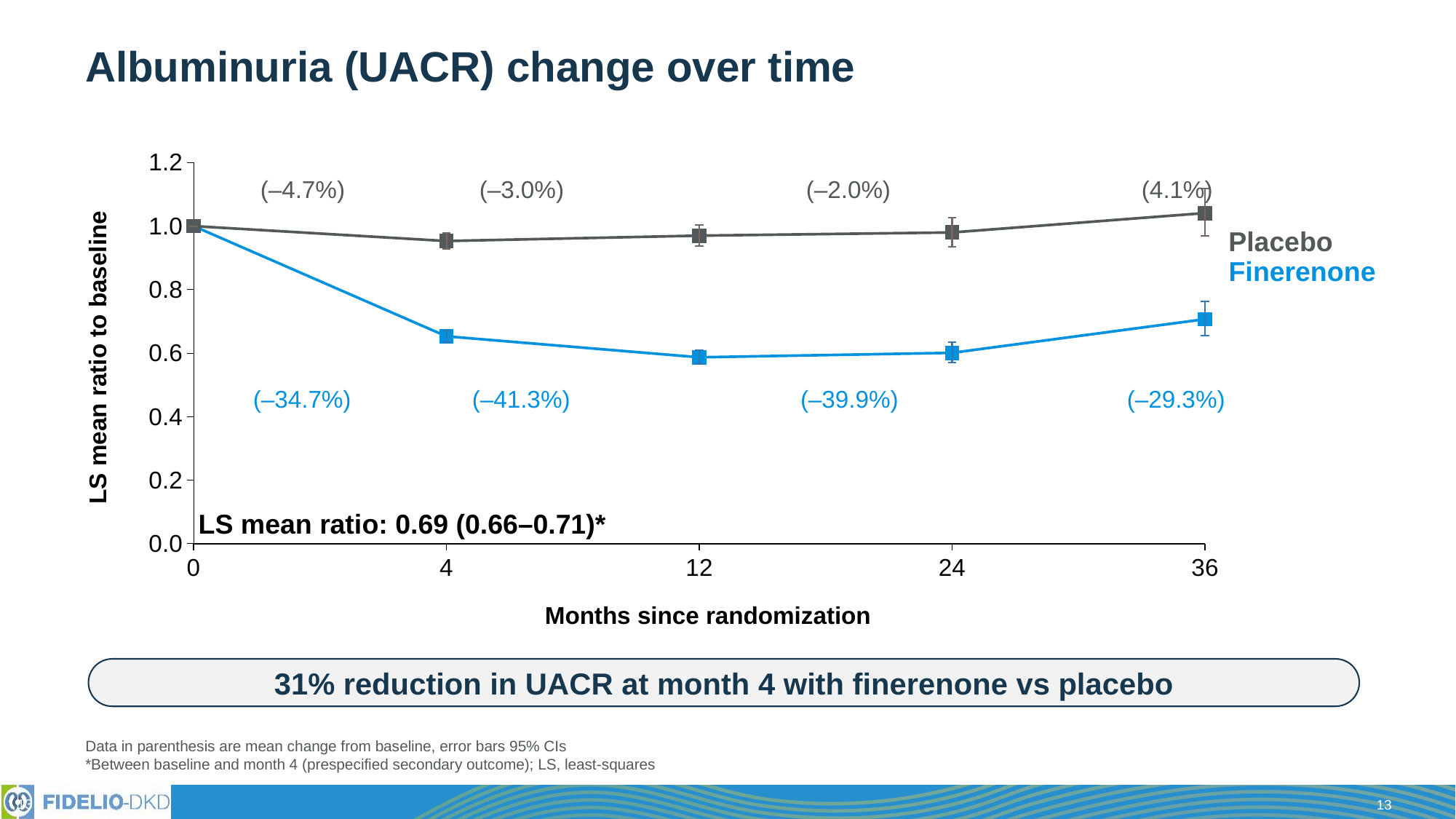
At which month is the finerenone mean change from baseline most negative? Month 12 What is the mean change from baseline for finerenone at month 12? –41.3% Does the finerenone line rise or fall between month 0 and month 12? Falls How many series are plotted in the chart? 2 What LS mean ratio is annotated on the chart? 0.69 (0.66–0.71) Is the LS mean ratio to baseline for finerenone at month 12 greater or less than 0.8? less What is the mean change from baseline for finerenone at month 4? –34.7% How many time points are plotted along the x axis? 5 What kind of chart is shown on the slide? Line chart At month 4, which series has the higher LS mean ratio to baseline, placebo or finerenone? Placebo What is the mean change from baseline for placebo at month 36? 4.1% Is the LS mean ratio to baseline for placebo at month 24 greater or less than 0.8? greater